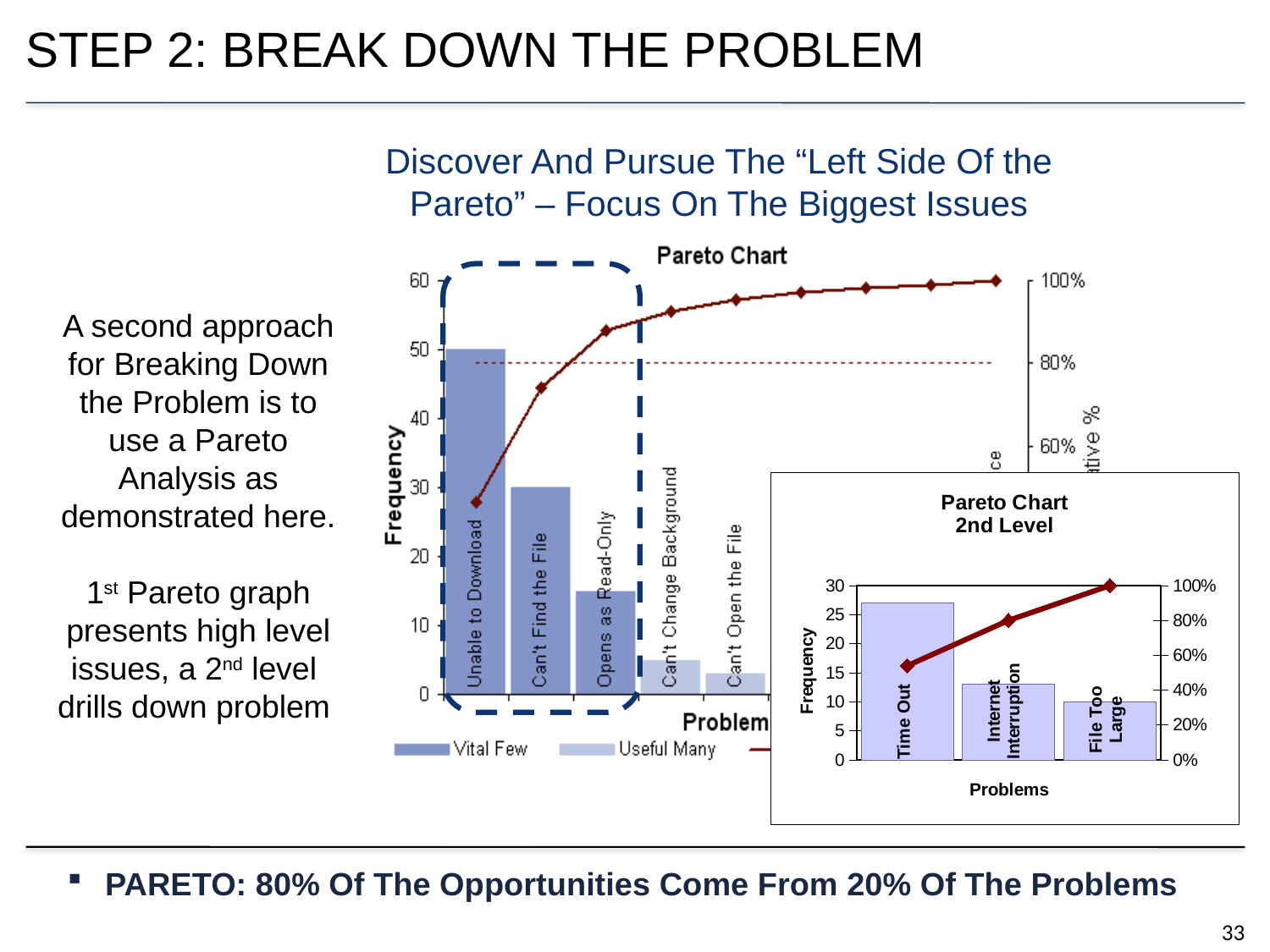
What kind of chart is the first-level Pareto Chart? bar chart with a line In the Pareto Chart 2nd Level, do the bar values rise or fall from left to right? fall In the first-level Pareto Chart, which problem has the highest frequency? Unable to Download In the Pareto Chart 2nd Level, is the frequency for Time Out greater or less than 25? greater In the first-level Pareto Chart, what is the difference in frequency between Unable to Download and Can't Find the File? 20 In the Pareto Chart 2nd Level, which problem has the highest frequency? Time Out In the first-level Pareto Chart, which has a higher frequency, Can't Find the File or Opens as Read-Only? Can't Find the File In the first-level Pareto Chart, what is the frequency for Unable to Download? 50 In the first-level Pareto Chart, what is the frequency for Can't Find the File? 30 In the first-level Pareto Chart, is the frequency for Opens as Read-Only greater or less than 20? less In the Pareto Chart 2nd Level, which problem has the lowest frequency? File Too Large In the Pareto Chart 2nd Level, how many problem categories are shown? 3